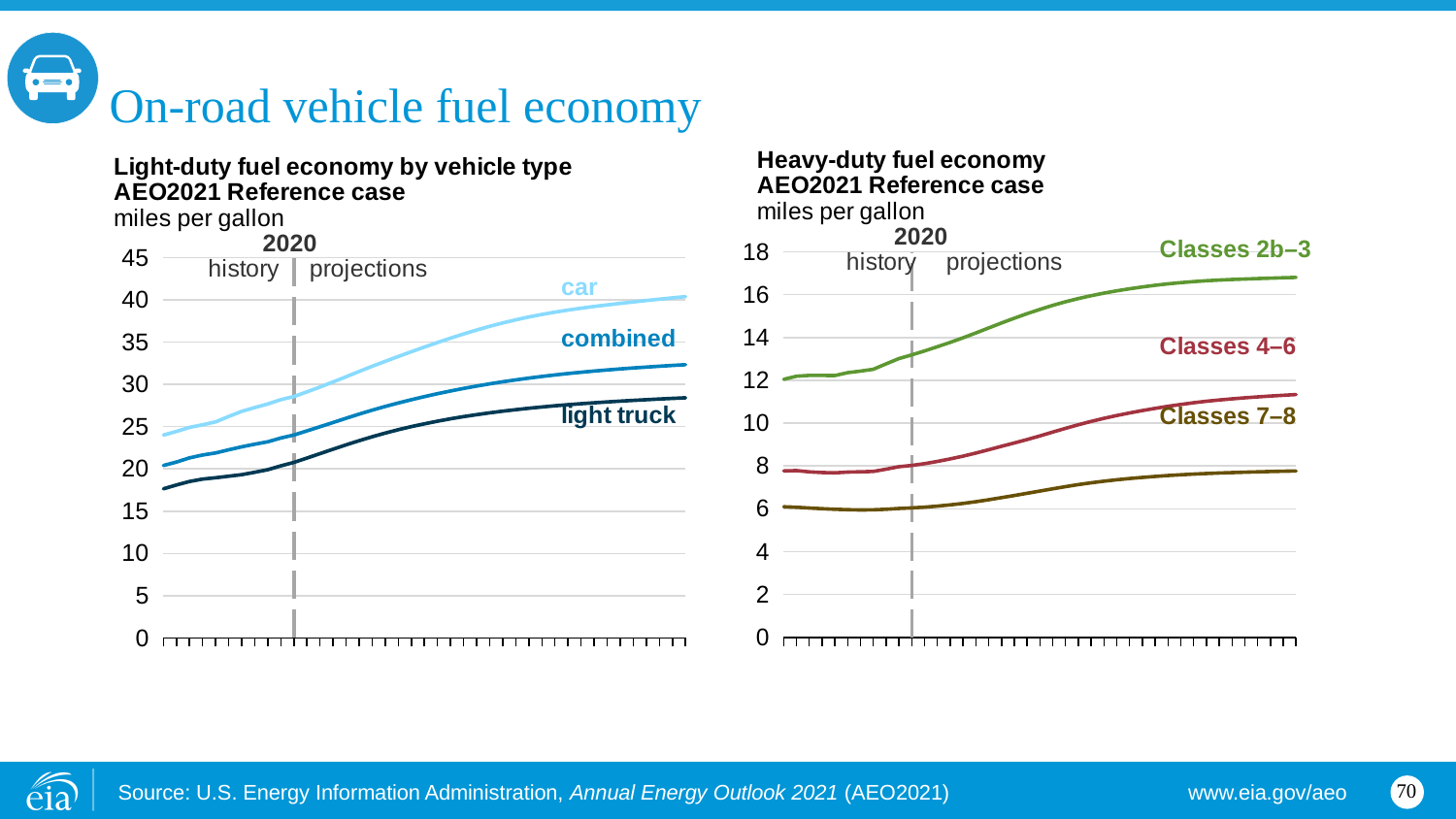
What kind of chart is the 'Heavy-duty fuel economy' chart? line chart How many series are plotted on the 'Light-duty fuel economy by vehicle type' chart? 3 What kind of chart is the 'Light-duty fuel economy by vehicle type' chart? line chart On the 'Light-duty fuel economy by vehicle type' chart, is the value for car at the end of the projections greater or less than 35? greater On the 'Heavy-duty fuel economy' chart, which series has the highest values? Classes 2b–3 On the 'Light-duty fuel economy by vehicle type' chart, which series has the highest values at the end of the projection period? car On the 'Heavy-duty fuel economy' chart, do the values for Classes 2b–3 rise or fall over the projection period? rise How many series are plotted on the 'Heavy-duty fuel economy' chart? 3 On the 'Heavy-duty fuel economy' chart, which series has the lowest values? Classes 7–8 On the 'Light-duty fuel economy by vehicle type' chart, which series has the lowest values throughout? light truck On the 'Heavy-duty fuel economy' chart, is the value for Classes 4–6 at the end of the projections greater or less than 10? greater On the 'Light-duty fuel economy by vehicle type' chart, is the value for light truck at the end of the projections greater or less than 30? less